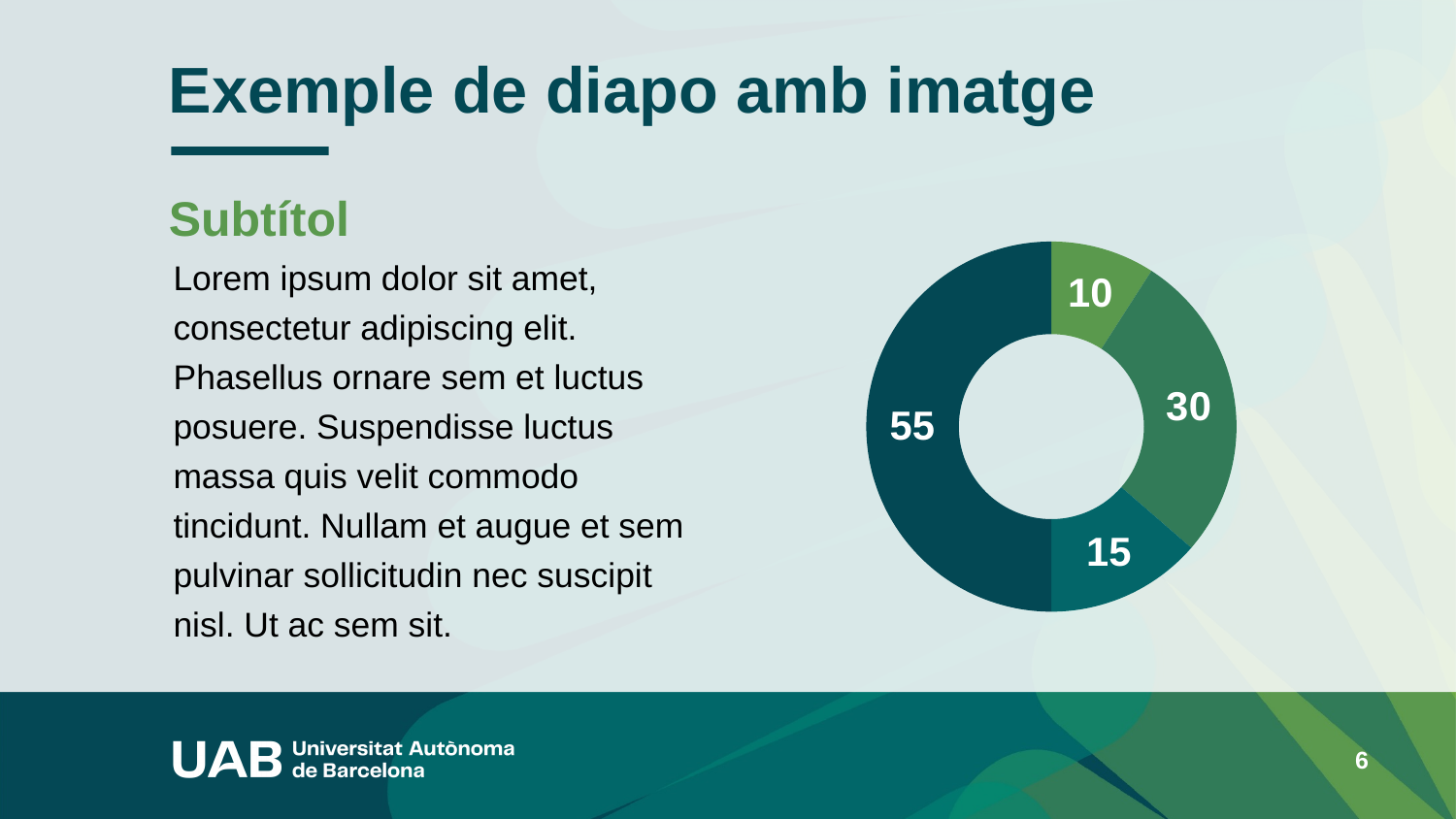
What is the difference between the slices labelled 30 and 15? 15 What value is shown on the dark teal slice that occupies the left half of the donut chart? 55 What is the smallest value shown in the donut chart? 10 Does the donut chart have a legend? No What is the difference between the largest slice (55) and the second-largest slice (30)? 25 What is the sum of all four values in the donut chart? 110 What value is shown on the lightest green slice of the donut chart? 10 What is the largest value shown in the donut chart? 55 What share of the total does the slice labelled 55 represent? 50% What kind of chart is shown on the slide? Donut chart Which is larger, the slice labelled 15 or the slice labelled 10? 15 How many slices does the donut chart have? 4